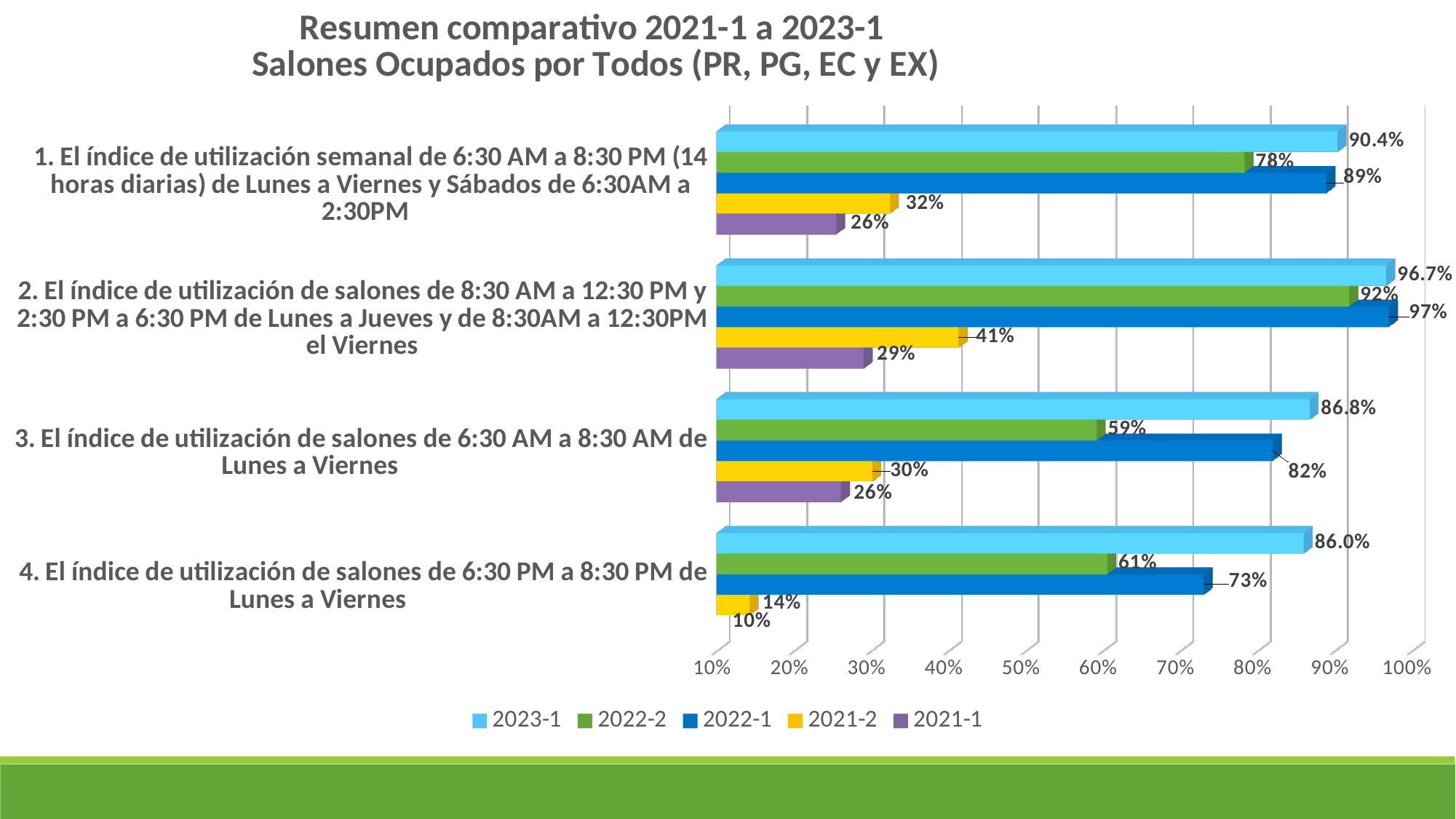
How many categories (numbered indices) are plotted on the chart? 4 What kind of chart is shown on the slide? bar chart Which category has the highest 2022-1 value? 2. El índice de utilización de salones de 8:30 AM a 12:30 PM y 2:30 PM a 6:30 PM de Lunes a Jueves y de 8:30AM a 12:30PM el Viernes What is the title of the chart? Resumen comparativo 2021-1 a 2023-1 Salones Ocupados por Todos (PR, PG, EC y EX) What is the 2021-1 value for category 4 (utilización de salones de 6:30 PM a 8:30 PM de Lunes a Viernes)? 10% For category 1 (utilización semanal de 6:30 AM a 8:30 PM), which is larger: the 2023-1 value or the 2022-1 value? 2023-1 What is the difference between the 2021-2 and 2021-1 values for category 2 (8:30 AM a 12:30 PM y 2:30 PM a 6:30 PM)? 12% What is the 2023-1 value for category 2 (utilización de salones de 8:30 AM a 12:30 PM y 2:30 PM a 6:30 PM)? 96.7% What is the 2022-2 value for category 3 (utilización de salones de 6:30 AM a 8:30 AM de Lunes a Viernes)? 59% What is the difference between the 2022-1 and 2022-2 values for category 3 (6:30 AM a 8:30 AM de Lunes a Viernes)? 23% Which category has the lowest 2021-2 value? 4. El índice de utilización de salones de 6:30 PM a 8:30 PM de Lunes a Viernes How many series does the legend list? 5